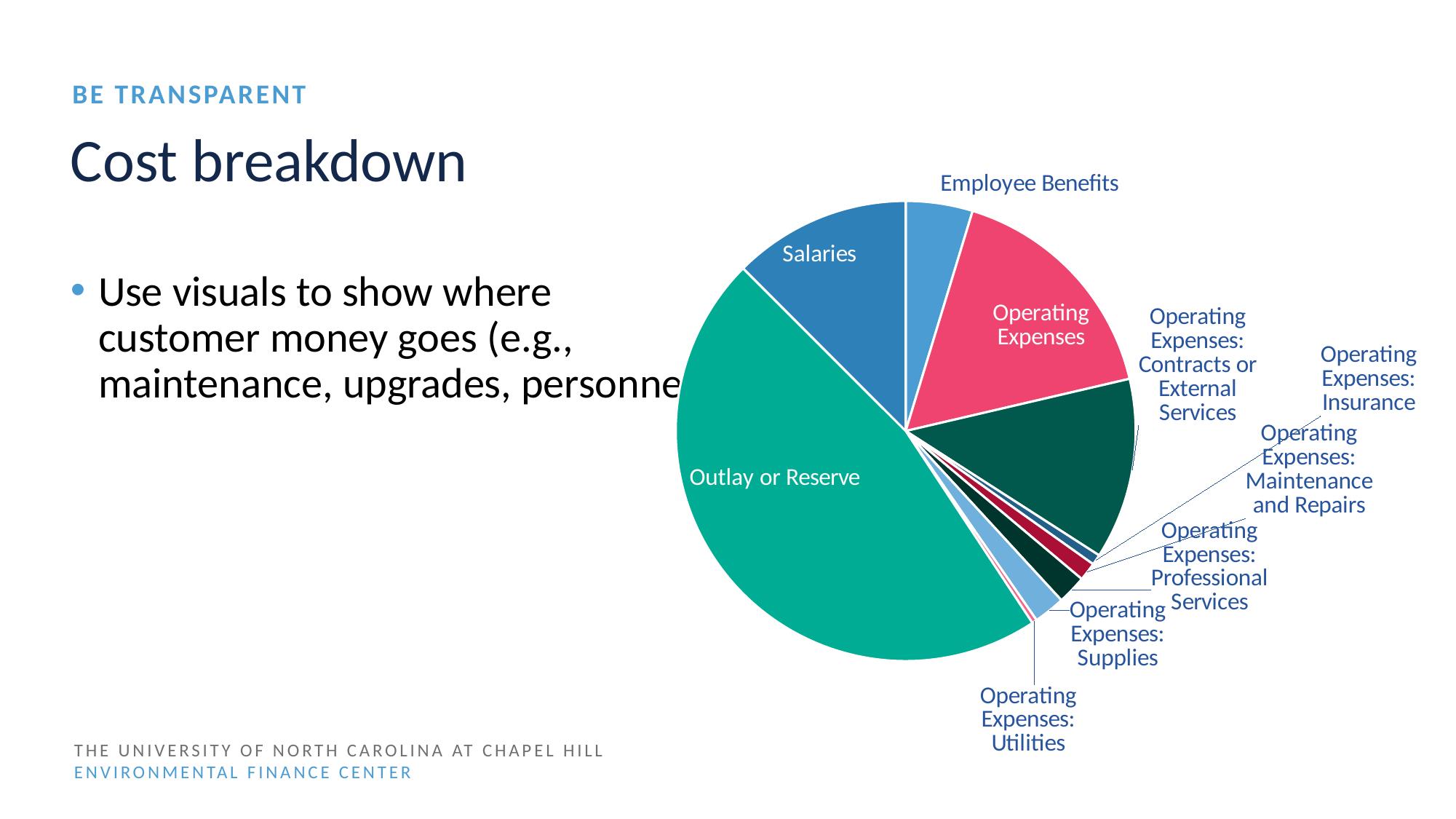
Which slice is larger, Operating Expenses or Employee Benefits? Operating Expenses Which slice is larger, Salaries or Employee Benefits? Salaries Which category has the largest slice of the pie chart? Outlay or Reserve What colour is the Outlay or Reserve slice of the pie chart? teal green What kind of chart is shown on the slide? pie chart How many slices does the pie chart have? 10 Which slice is larger, Outlay or Reserve or Salaries? Outlay or Reserve What is the title of the slide containing the pie chart? Cost breakdown